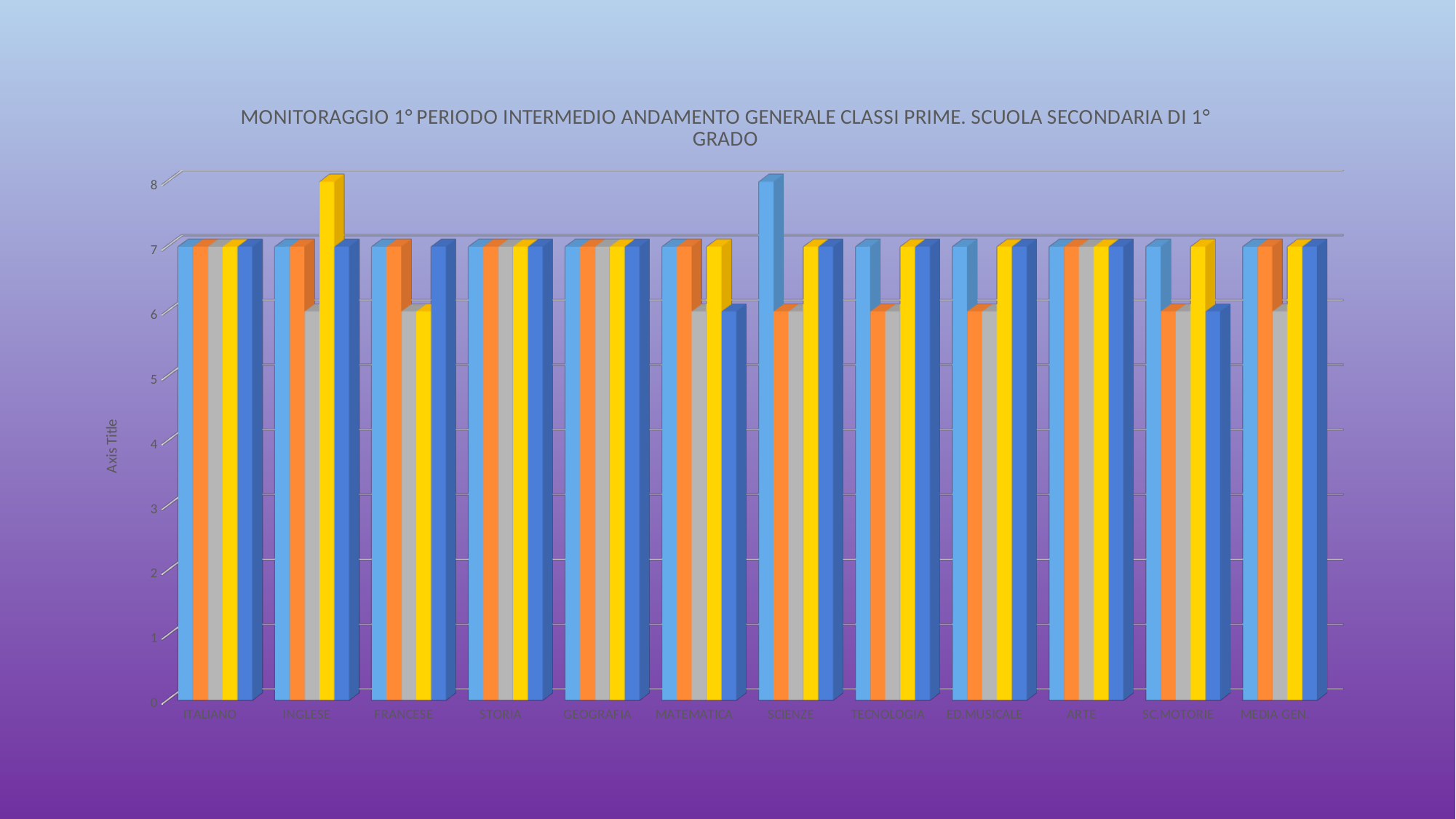
What is the value of the yellow bar for INGLESE? 8 How many subject categories are shown along the x axis? 12 What is the value of the orange bar for ITALIANO? 7 For which subject is the light blue bar highest? SCIENZE How many bars are plotted for each subject category? 5 For which subject is the yellow bar highest? INGLESE Which is larger for MATEMATICA: the yellow bar or the dark blue bar? yellow bar What is the label shown on the vertical axis? Axis Title What kind of chart is shown on the slide? bar chart Is the value of the orange bar for SC.MOTORIE greater or less than 7? less What is the value of the gray bar for FRANCESE? 6 What is the value of the light blue bar for SCIENZE? 8